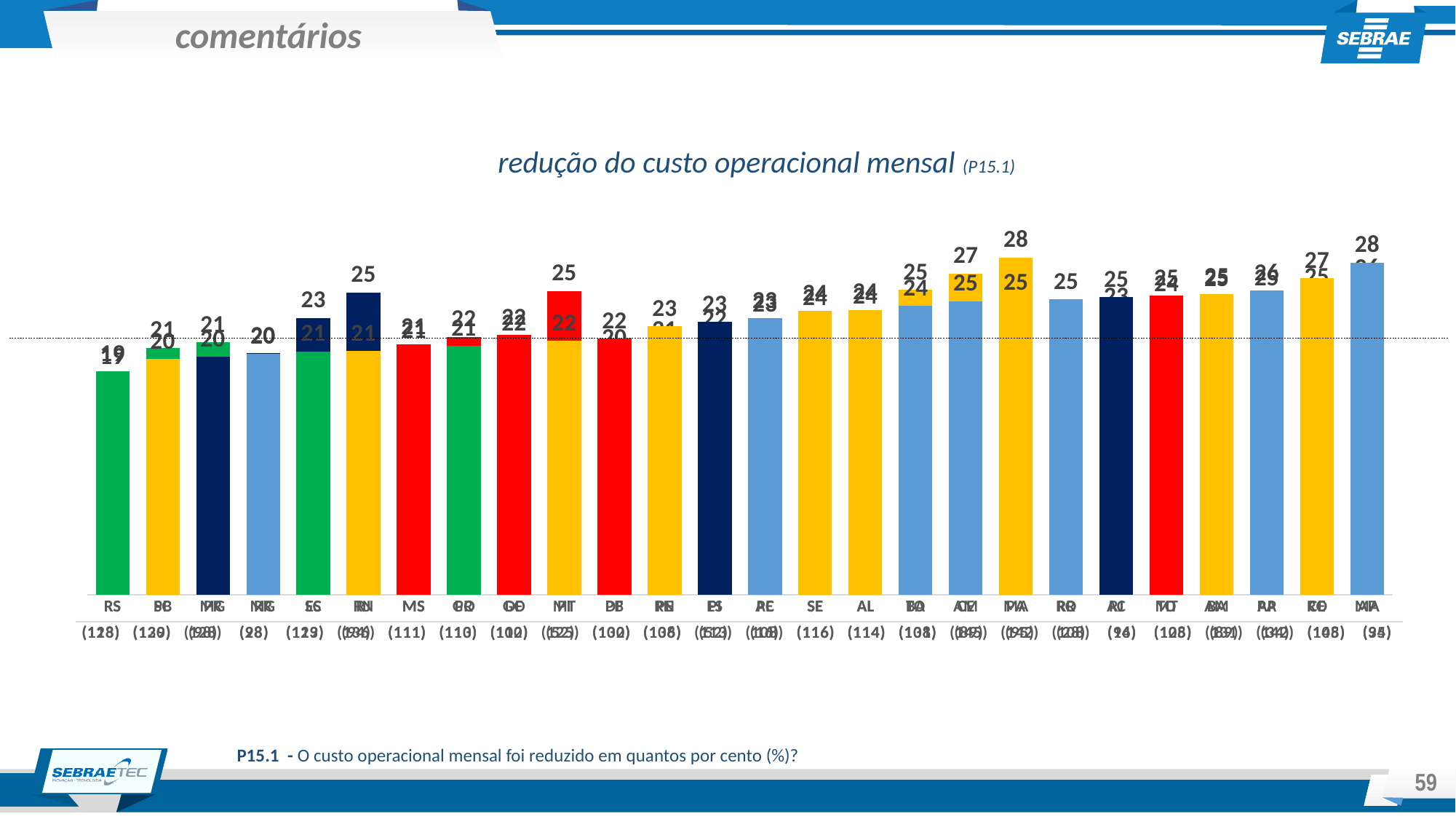
What is the highest value printed on the chart? 28 Which has the larger value, AL or MS? AL How many bars are plotted on the chart? 26 Which has the larger value, SE or RS? SE What is the title of the chart? redução do custo operacional mensal (P15.1) Which has the larger value, RS or AL? AL Which survey question code is referenced in the chart title? P15.1 What kind of chart is shown on the slide? bar chart